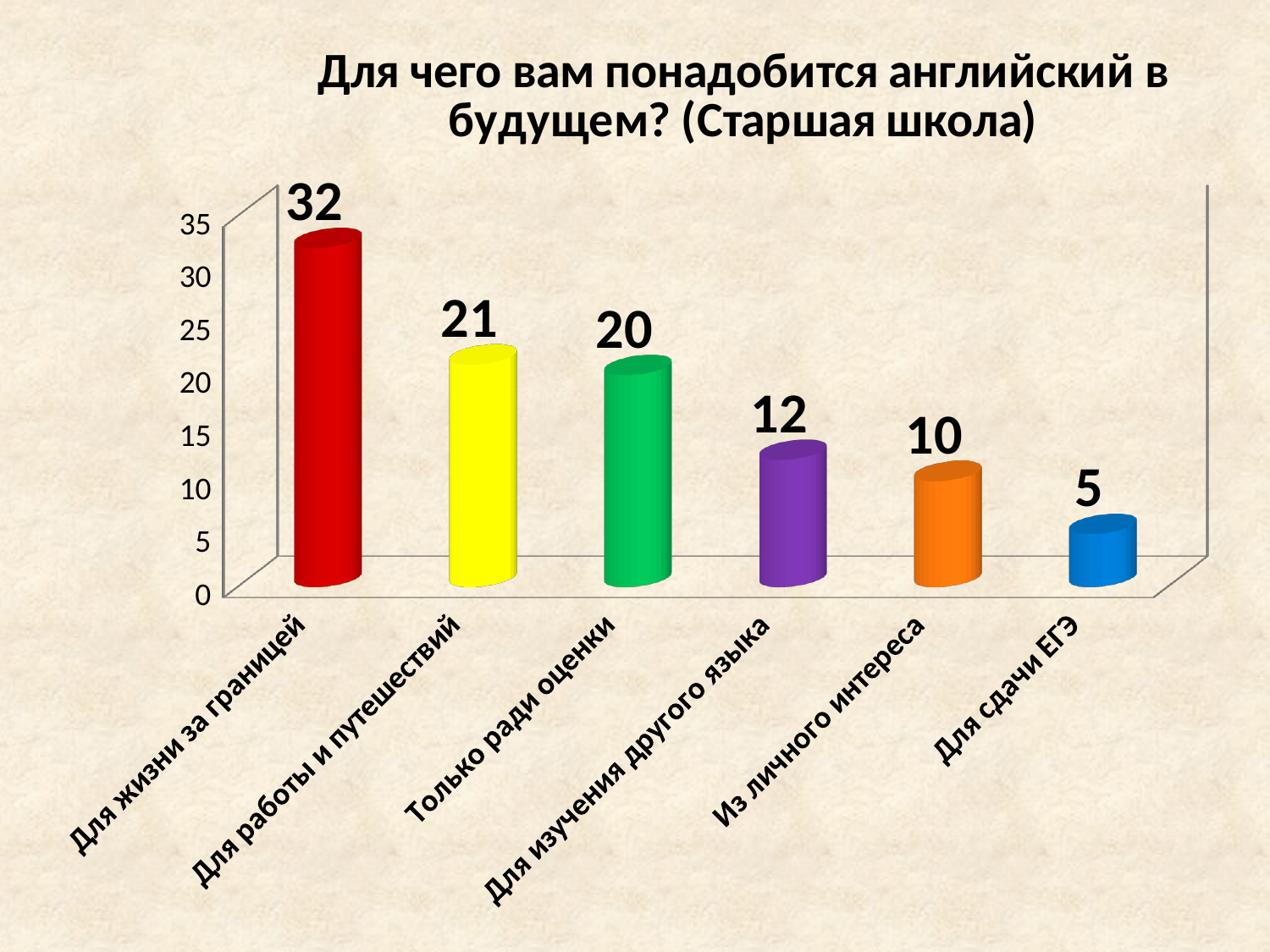
Do the values rise or fall from left to right along the x axis? fall How many categories are shown in the chart? 6 What kind of chart is shown on the slide? bar chart Which category has the lowest value? Для сдачи ЕГЭ What is the difference between the values for "Для изучения другого языка" and "Для сдачи ЕГЭ"? 7 What is the value for "Для сдачи ЕГЭ"? 5 What is the value for "Для жизни за границей"? 32 Which is larger, the value for "Только ради оценки" or the value for "Из личного интереса"? Только ради оценки What is the difference between the values for "Для жизни за границей" and "Для работы и путешествий"? 11 What is the title of the chart? Для чего вам понадобится английский в будущем? (Старшая школа) What is the value for "Из личного интереса"? 10 Which category has the highest value? Для жизни за границей